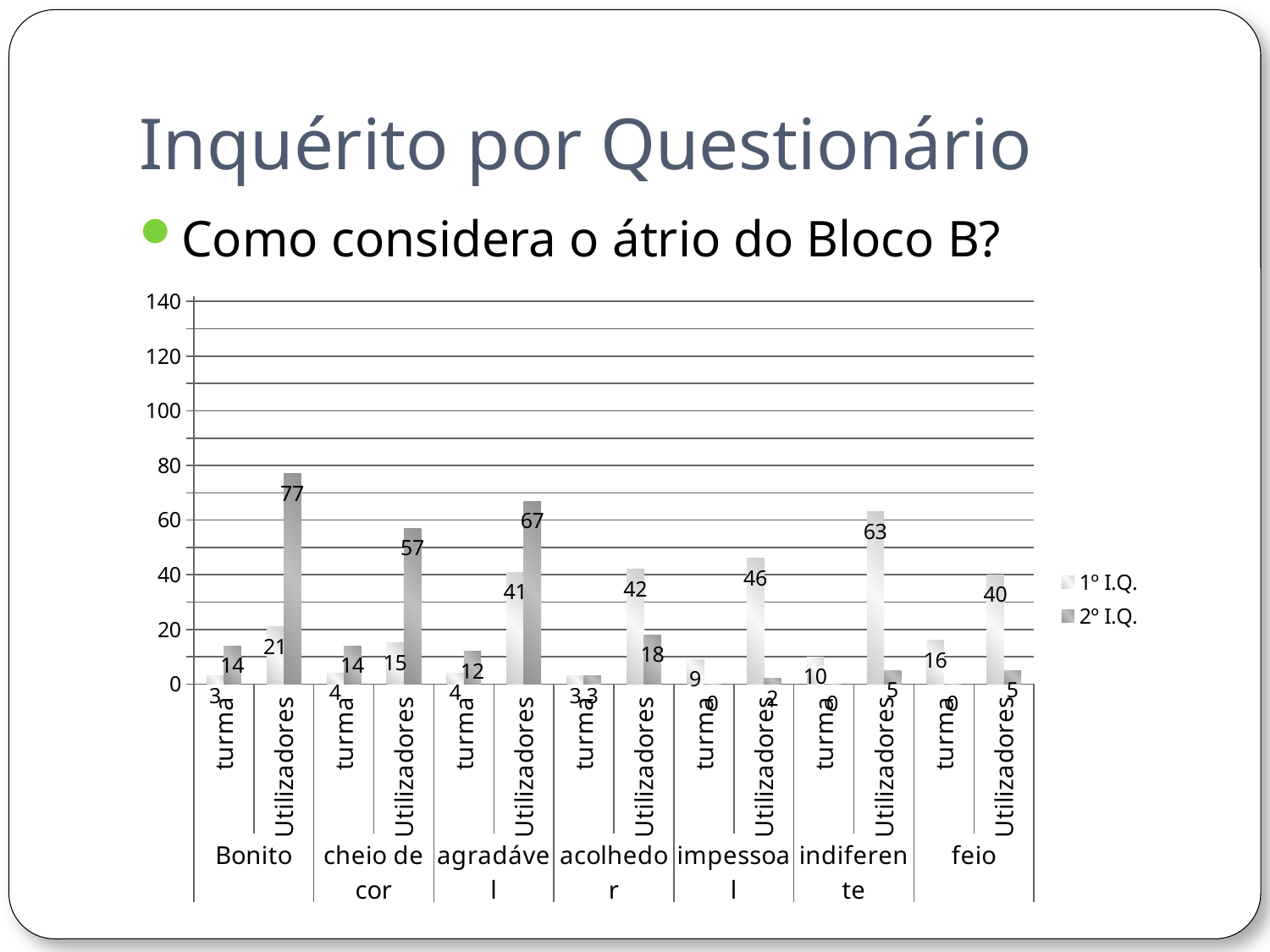
Is the 2º I.Q. value for Utilizadores under Bonito greater or less than 60? greater How many series does the legend list? 2 Which bar has the highest value in the chart? 2º I.Q. for Utilizadores under Bonito How many main categories (adjectives) are shown along the x axis? 7 What are the two entries in the legend? 1º I.Q. and 2º I.Q. What is the difference between the 2º I.Q. and 1º I.Q. values for Utilizadores under Bonito? 56 What is the 2º I.Q. value for Utilizadores under cheio de cor? 57 For Utilizadores under agradável, which series has the larger value, 1º I.Q. or 2º I.Q.? 2º I.Q. What kind of chart is shown on the slide? bar chart What is the 1º I.Q. value for Utilizadores under impessoal? 46 What is the 2º I.Q. value for Utilizadores under Bonito? 77 What is the 1º I.Q. value for Utilizadores under indiferente? 63